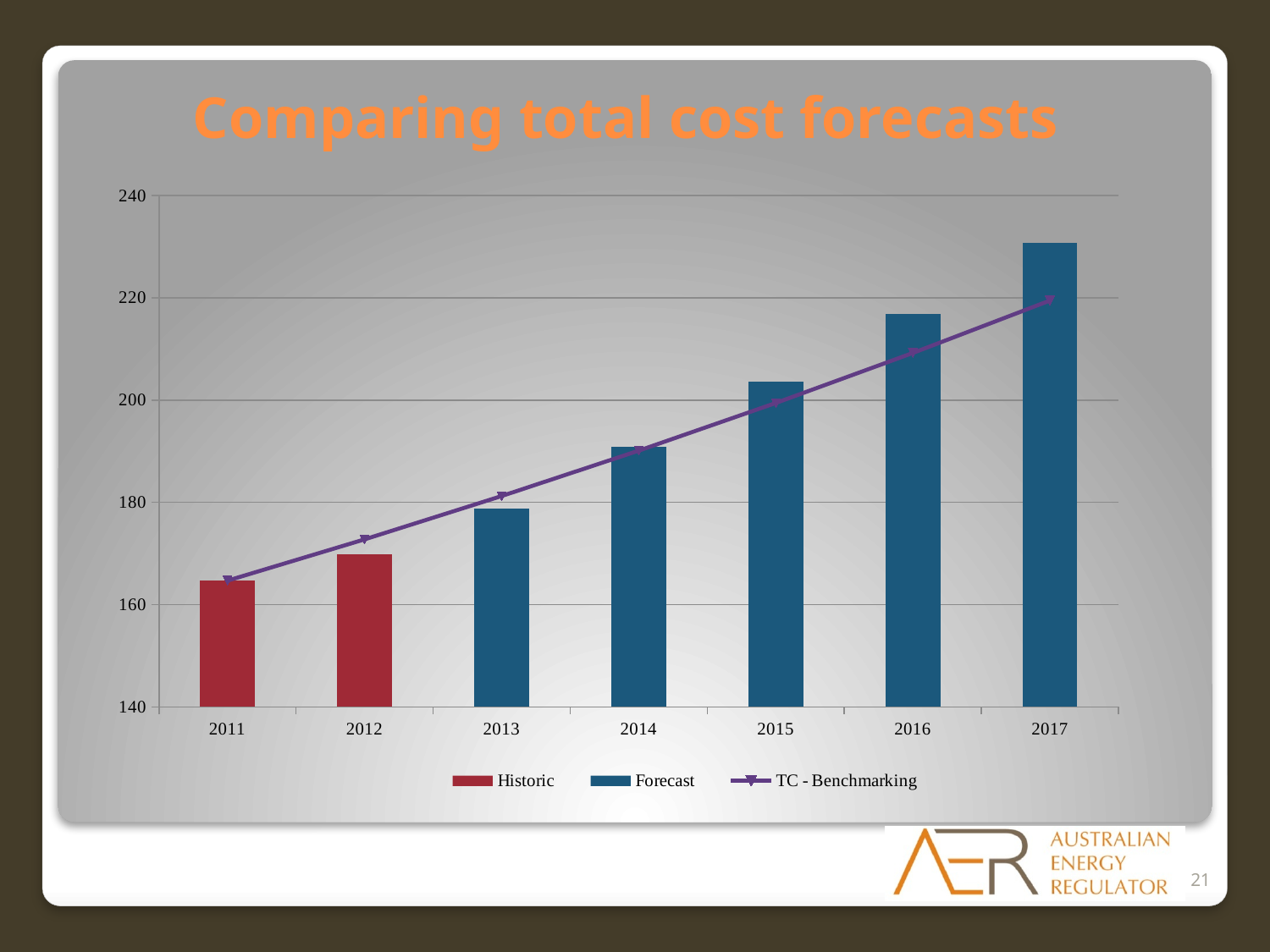
Is the bar value for 2016 greater or less than 220? less Which year has the shortest bar in the chart? 2011 How many series does the chart's legend list? 3 Is the bar value for 2017 greater or less than 220? greater Which year has the tallest bar in the chart? 2017 How many years are shown on the x axis of the chart? 7 Which is larger, the bar for 2011 or the bar for 2012? 2012 In 2017, which is higher, the Forecast bar or the TC - Benchmarking line? The Forecast bar Is the bar value for 2011 greater or less than 160? greater Which series in the legend is drawn as a line with markers? TC - Benchmarking Do the bar values rise or fall from 2011 to 2017? Rise What kind of chart is shown on the slide? A bar chart with a line series